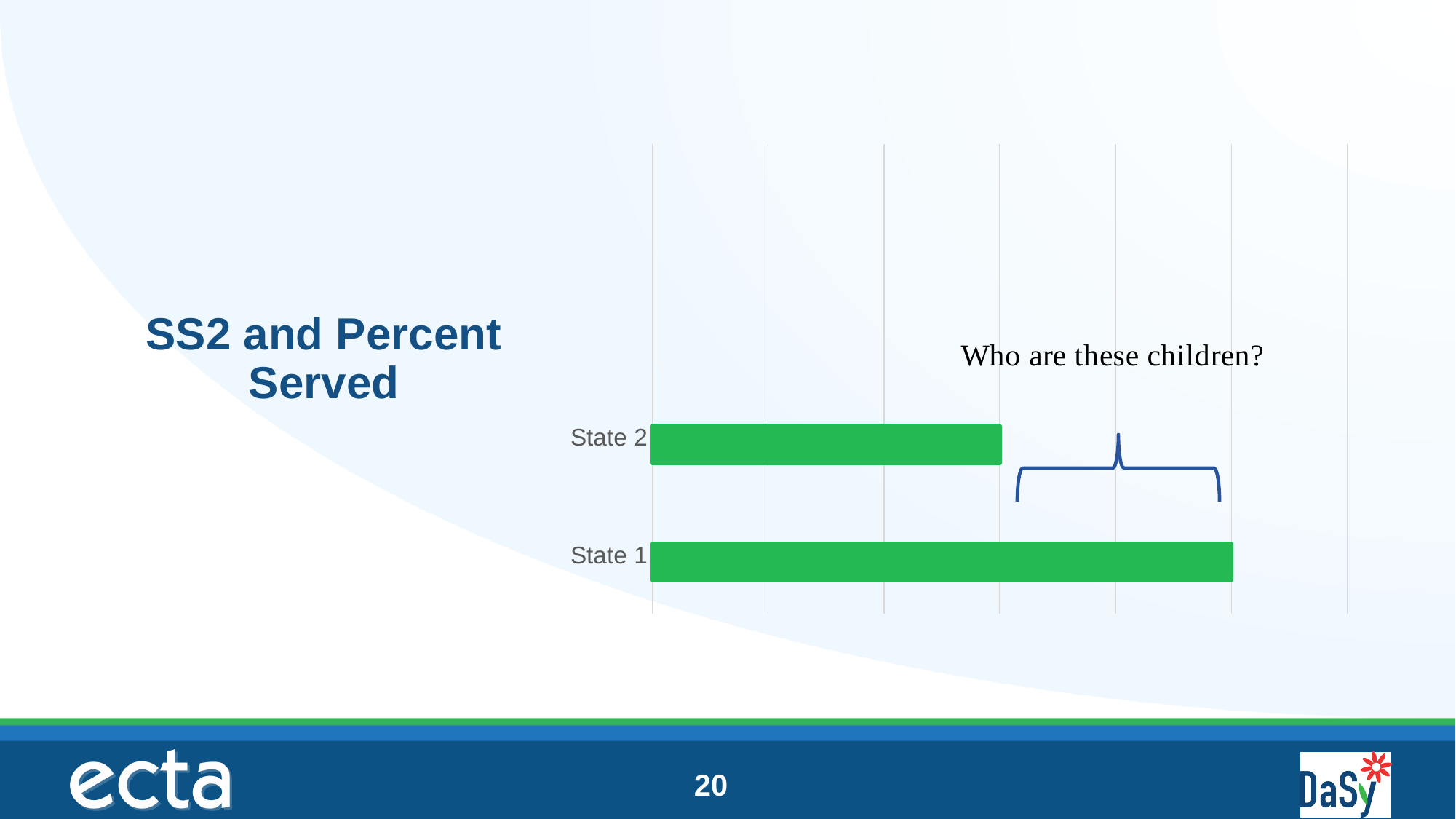
What kind of chart is shown on the slide? bar chart What question is written above the bracket on the chart? Who are these children? Which state has the shortest bar in the chart? State 2 Which bar is longer, State 1 or State 2? State 1 How many categories (bars) does the chart show? 2 What is the title text shown to the left of the chart? SS2 and Percent Served Which state has the longest bar in the chart? State 1